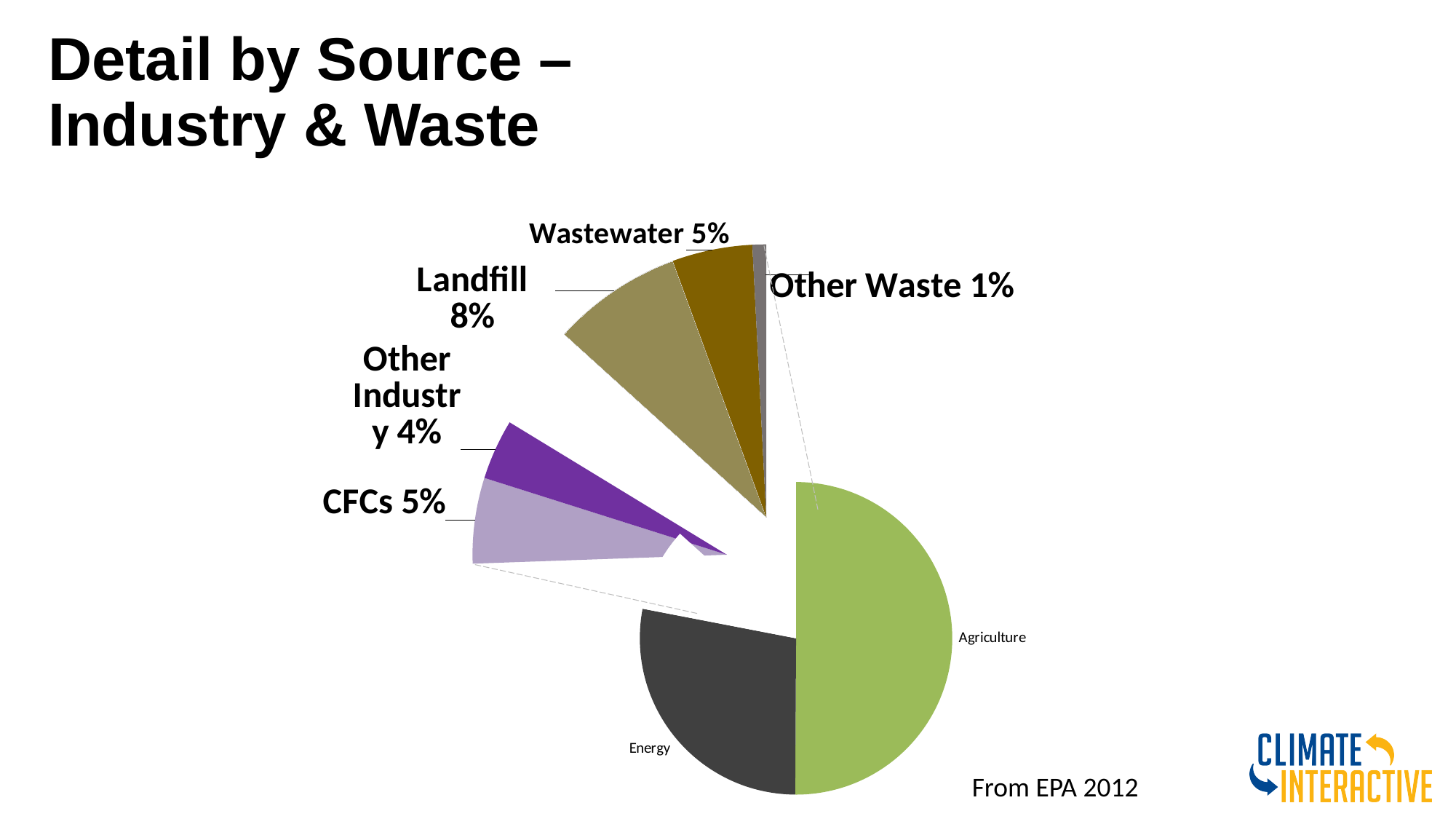
What kind of chart is shown on the slide? pie chart How many percentage points larger is the Landfill slice than the Wastewater slice? 3% What percentage does the Other Industry slice represent? 4% Which slice is larger, Agriculture or Energy? Agriculture What percentage does the Landfill slice represent? 8% What percentage does the Other Waste slice represent? 1% Among the slices with printed percentages, which one is the smallest? Other Waste What source is cited for the chart data? From EPA 2012 What percentage does the CFCs slice represent? 5% What percentage does the Wastewater slice represent? 5% How many slices are labeled in the pie chart? 7 Among the slices with printed percentages, which one is the largest? Landfill